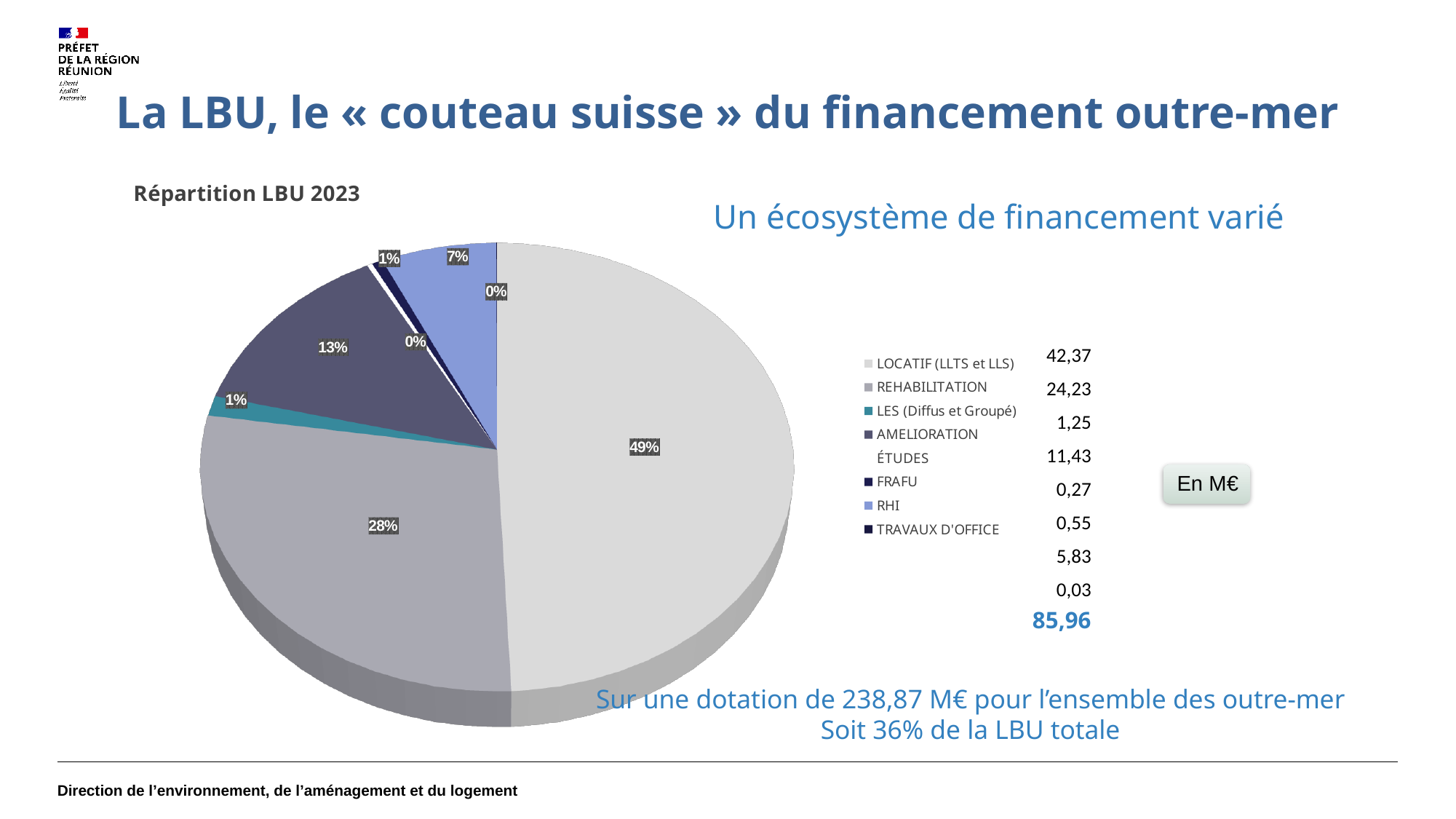
What share of the pie does AMELIORATION represent? 13% What is the title of the pie chart? Répartition LBU 2023 How many entries does the legend of the pie chart list? 8 What share of the pie does REHABILITATION represent? 28% What unit is indicated in the box next to the legend? En M€ What total value in M€ is printed in bold below the list of values next to the pie chart? 85,96 What kind of chart is shown on the slide? pie chart Which category has the largest slice of the pie? LOCATIF (LLTS et LLS) What share of the pie does LOCATIF (LLTS et LLS) represent? 49% Which slice is larger, REHABILITATION or AMELIORATION? REHABILITATION What is the difference in percentage points between the LOCATIF (LLTS et LLS) slice and the REHABILITATION slice? 21 percentage points